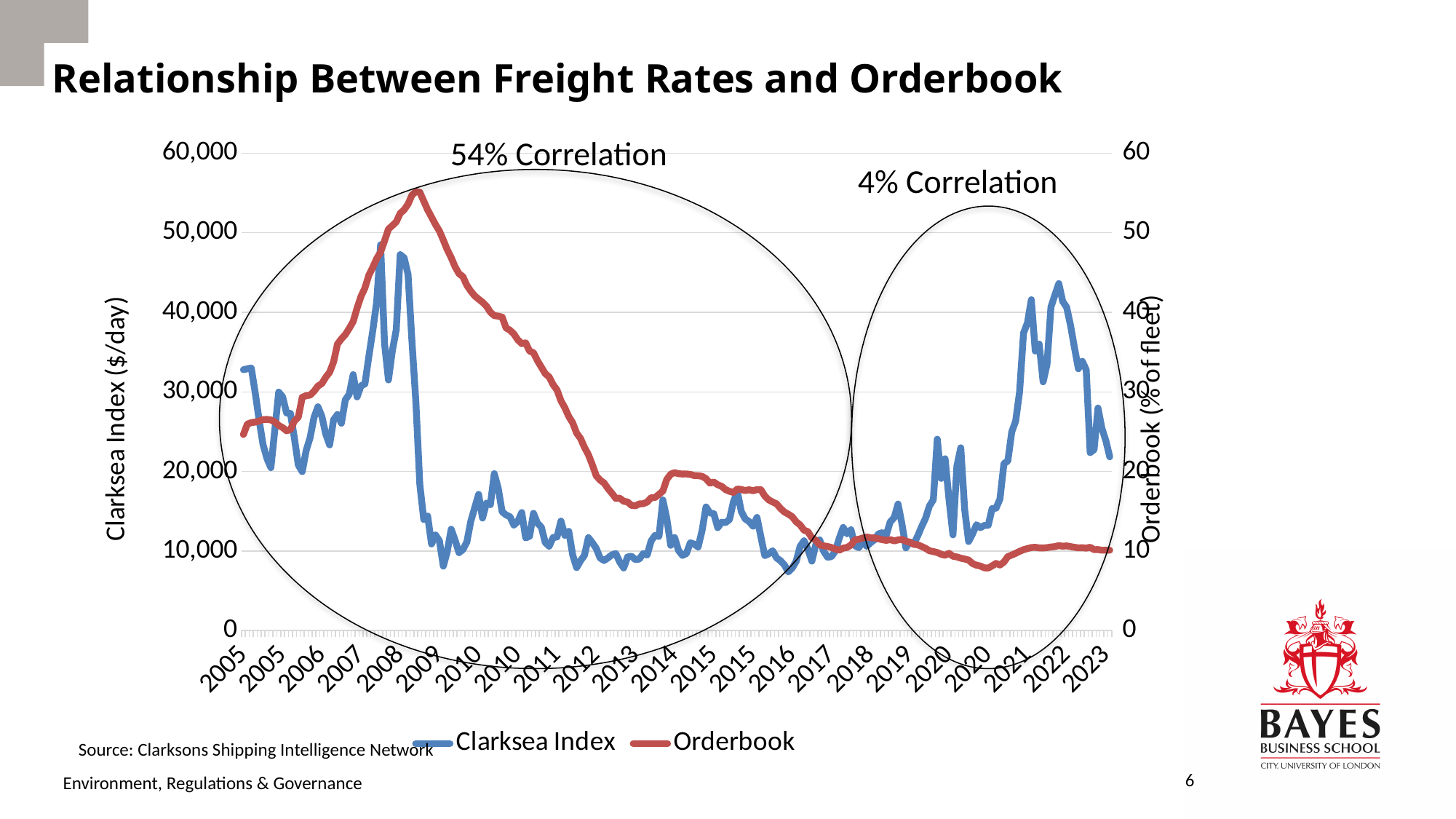
Is the peak value of the Clarksea Index around 2022 greater or less than 40,000? greater How many series does the legend list? 2 Does the Clarksea Index rise or fall between 2020 and its 2022 peak? Rise Is the Clarksea Index value at the end of 2023 greater or less than 30,000? less What correlation is annotated for the earlier (larger) circled period of the chart? 54% Correlation Which is larger: the Orderbook value around 2008 or the Orderbook value around 2020? Around 2008 Does the Orderbook series rise or fall between 2008 and 2013? Fall What correlation is annotated for the later (2019–2023) circled period of the chart? 4% Correlation Is the Orderbook value around 2020 greater or less than 10 on the right axis? less What kind of chart is shown on the slide? Line chart